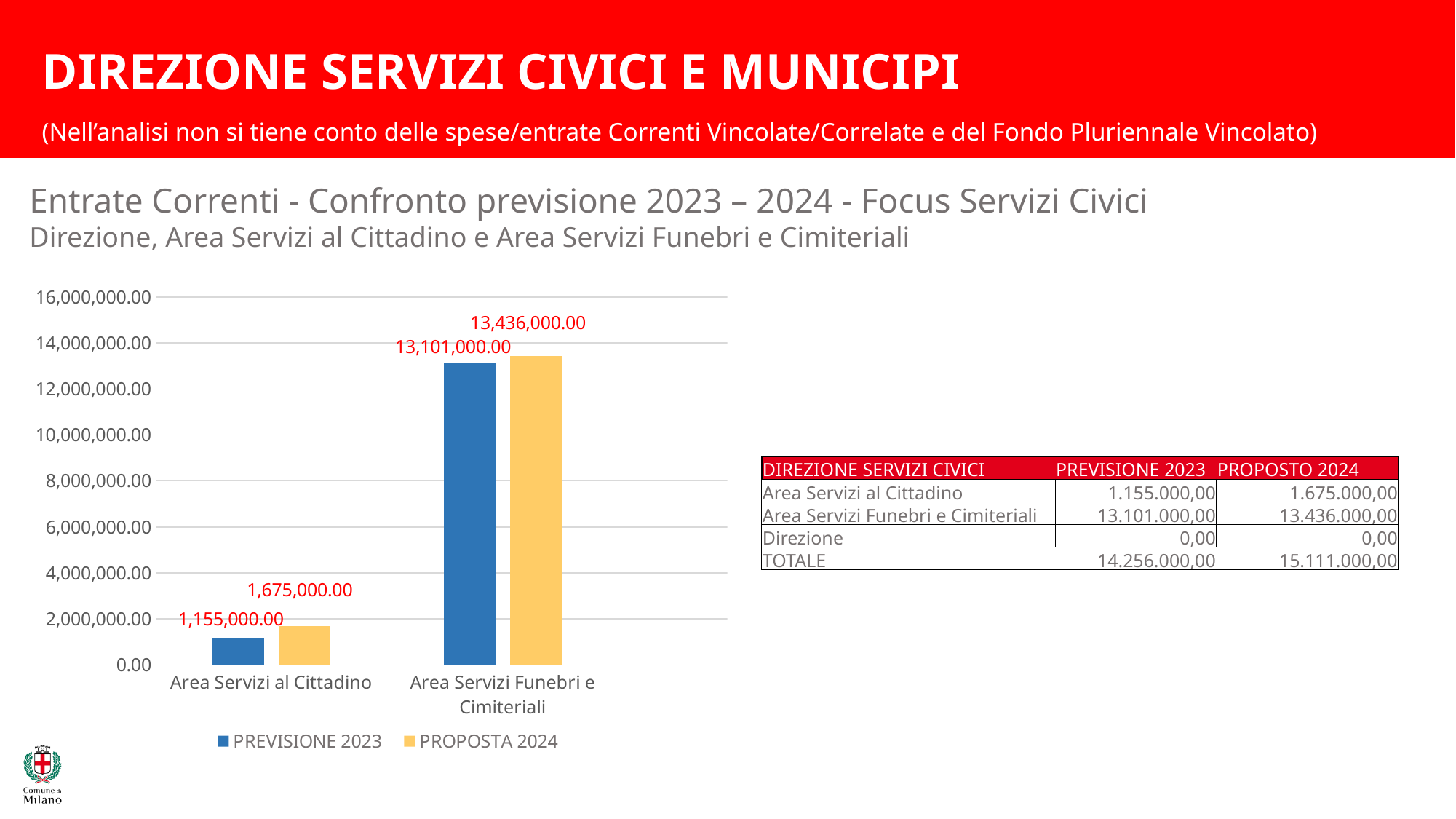
What is the PREVISIONE 2023 value for Area Servizi al Cittadino? 1,155,000.00 What is the PREVISIONE 2023 value for Area Servizi Funebri e Cimiteriali? 13,101,000.00 How many series does the chart legend list? 2 For Area Servizi Funebri e Cimiteriali, which is larger: PREVISIONE 2023 or PROPOSTA 2024? PROPOSTA 2024 What is the difference between the PROPOSTA 2024 and PREVISIONE 2023 values for Area Servizi Funebri e Cimiteriali? 335,000.00 What kind of chart is shown on the slide? Bar chart What is the PROPOSTA 2024 value for Area Servizi Funebri e Cimiteriali? 13,436,000.00 Which category has the lowest PREVISIONE 2023 value? Area Servizi al Cittadino How many categories are shown on the x axis of the chart? 2 Which category has the highest PROPOSTA 2024 value? Area Servizi Funebri e Cimiteriali What is the PROPOSTA 2024 value for Area Servizi al Cittadino? 1,675,000.00 What is the difference between the PROPOSTA 2024 and PREVISIONE 2023 values for Area Servizi al Cittadino? 520,000.00